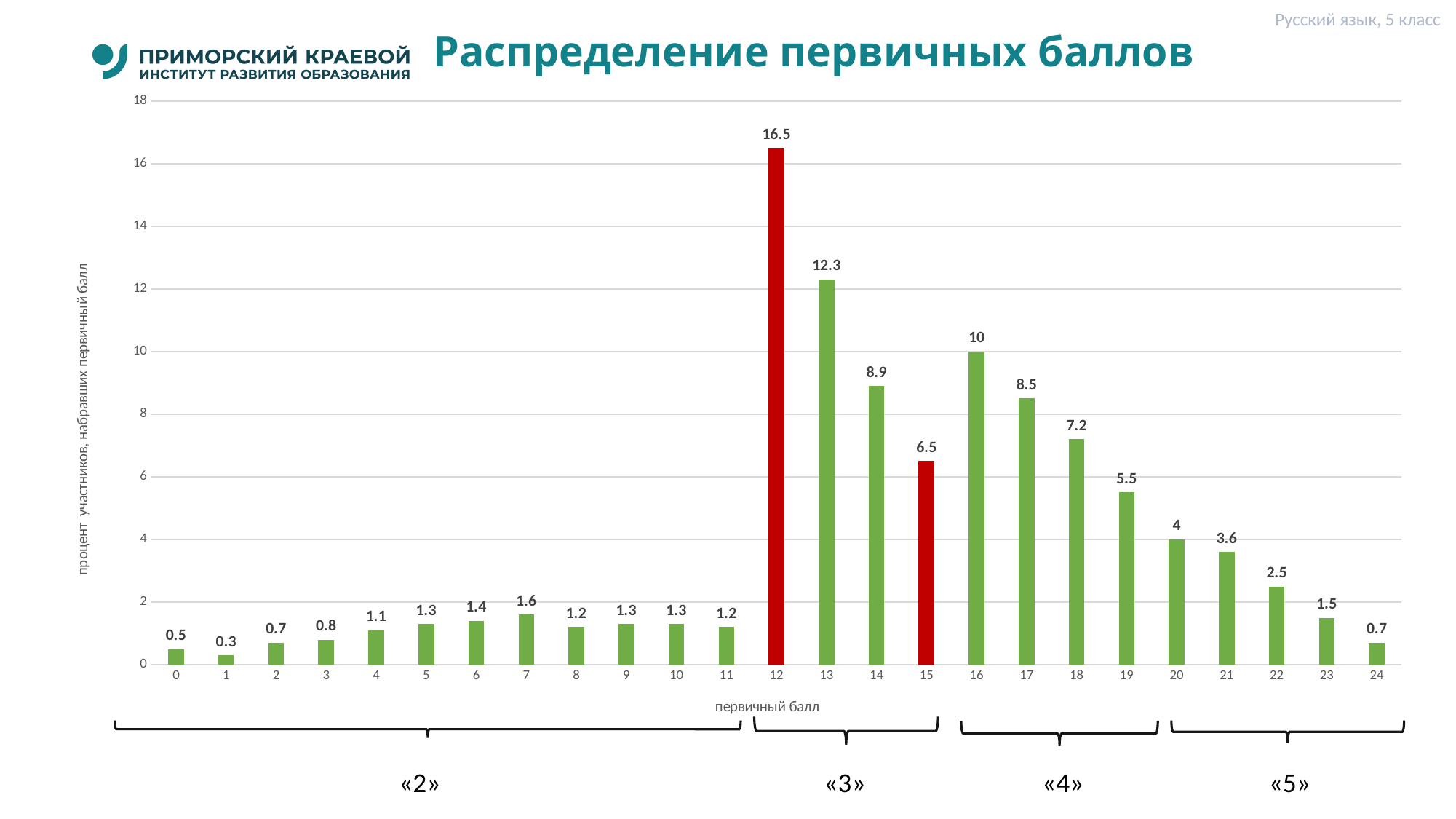
Which primary score has the highest percentage of participants? 12 Do the values rise or fall from primary score 16 to primary score 24? fall What percentage of participants scored 12 primary points? 16.5 Which two bars are coloured red? 12 and 15 What type of chart is shown on the slide? bar chart What is the value shown for primary score 0? 0.5 What is the value shown for primary score 18? 7.2 Which primary score has the lowest percentage of participants? 1 What is the difference between the values for primary scores 12 and 13? 4.2 How many primary score categories are shown on the x axis? 25 Which has a larger value: primary score 16 or primary score 17? 16 Is the value for primary score 14 greater or less than 8? greater